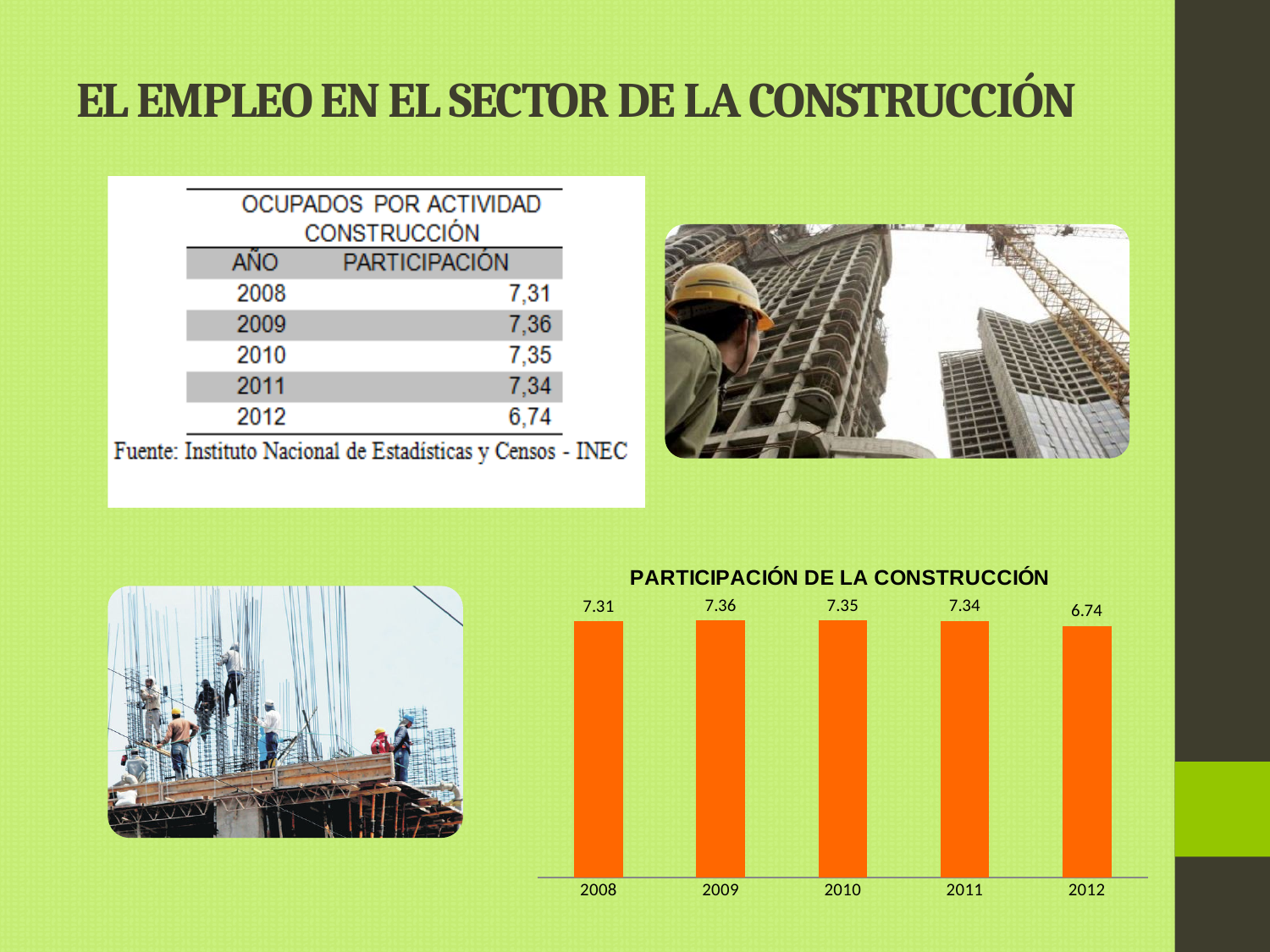
How many years are shown in the chart? 5 Which year has the lowest value in the chart? 2012 What is the value for 2008 in the chart? 7.31 Which is larger, the value for 2011 or the value for 2012? 2011 What is the value for 2010 in the chart? 7.35 What is the title of the chart on the slide? PARTICIPACIÓN DE LA CONSTRUCCIÓN From 2009 to 2012, do the values in the chart rise or fall? fall What is the value for 2012 in the chart? 6.74 What is the difference between the values for 2008 and 2012? 0.57 What type of chart is shown on the slide? bar chart Which year has the highest value in the chart? 2009 What colour are the bars in the chart? orange